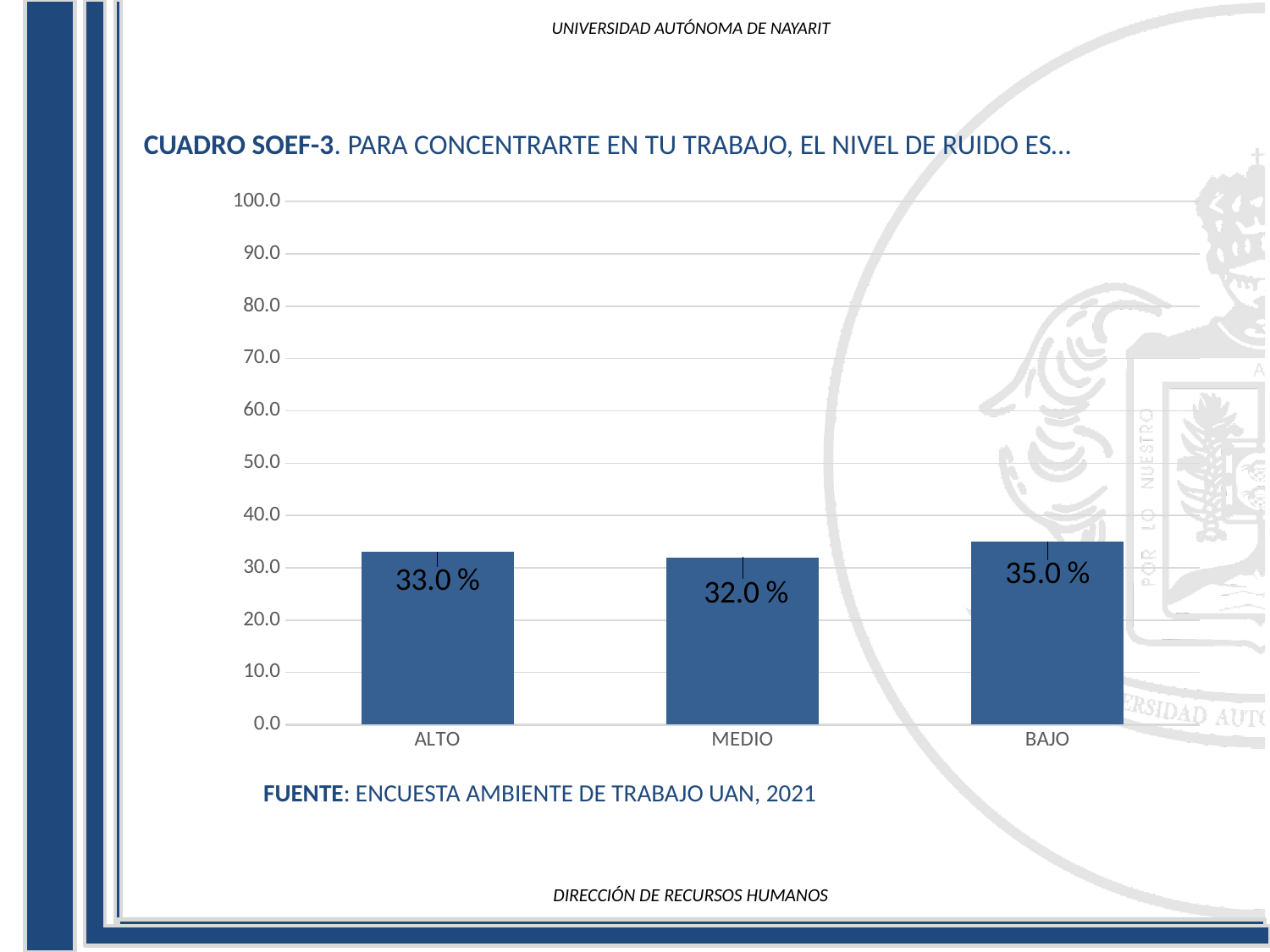
What is the source cited below the chart? ENCUESTA AMBIENTE DE TRABAJO UAN, 2021 Which category has the highest value? BAJO What is the difference between the values for ALTO and MEDIO? 1.0 % How many categories are shown on the x axis? 3 What is the difference between the values for BAJO and MEDIO? 3.0 % What is the value for ALTO? 33.0 % Is the value for BAJO greater or less than 40.0? less Which is larger, the value for BAJO or the value for ALTO? BAJO What kind of chart is shown on the slide? bar chart Which category has the lowest value? MEDIO What is the value for BAJO? 35.0 % What is the value for MEDIO? 32.0 %